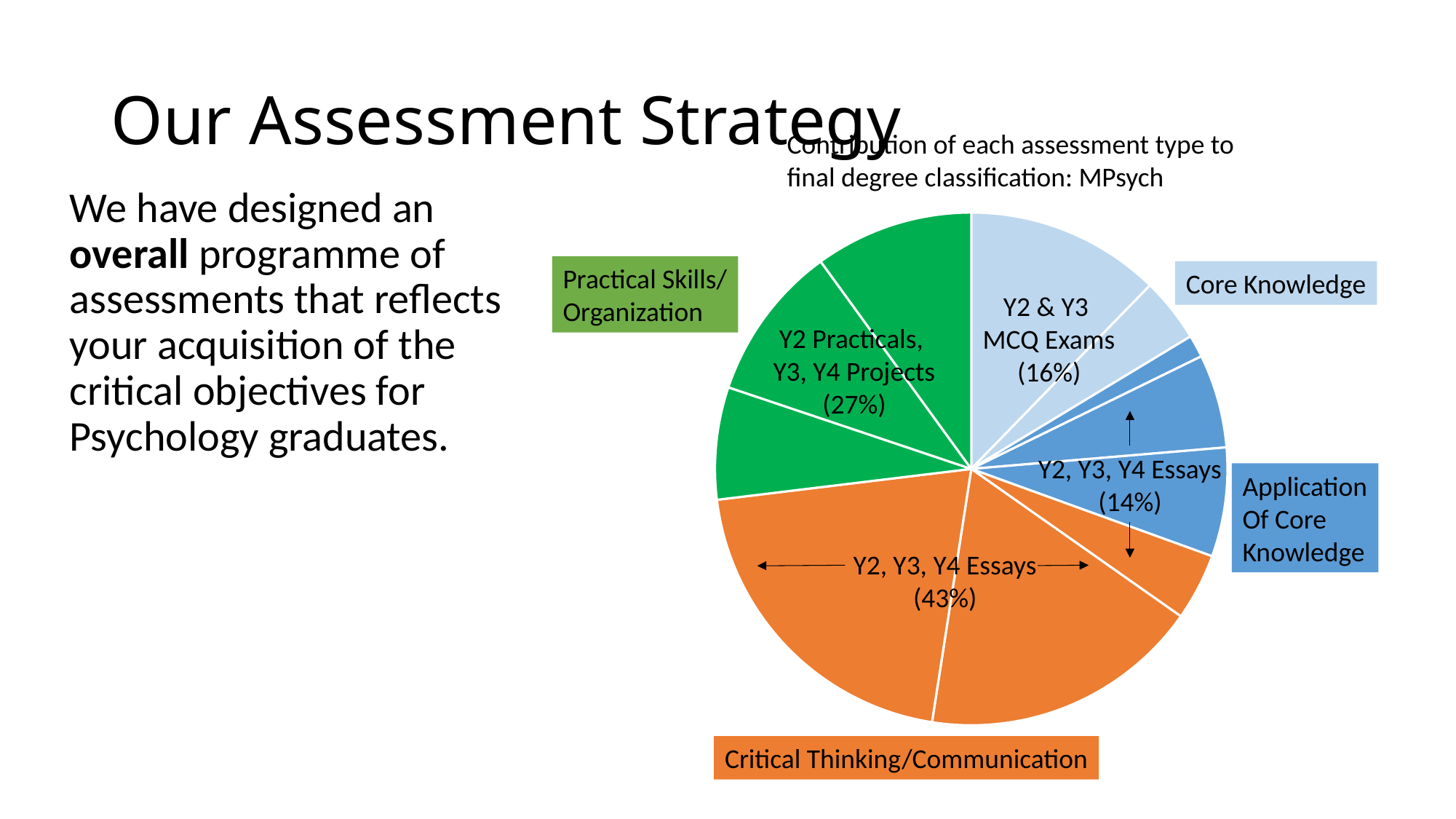
What percentage is attributed to Y2 Practicals, Y3, Y4 Projects (Practical Skills/Organization)? 27% Which assessment category contributes the smallest share to the final degree classification? Application Of Core Knowledge (Y2, Y3, Y4 Essays, 14%) Which assessment category contributes the largest share to the final degree classification? Critical Thinking/Communication (Y2, Y3, Y4 Essays, 43%) What is the difference in percentage points between the Critical Thinking/Communication share and the Practical Skills/Organization share? 16 How many labelled assessment categories are shown in the pie chart? 4 What percentage of the final degree classification comes from Y2 & Y3 MCQ Exams (Core Knowledge)? 16% What is the title of the pie chart? Contribution of each assessment type to final degree classification: MPsych What percentage is attributed to Y2, Y3, Y4 Essays under Application Of Core Knowledge? 14% What percentage is attributed to Y2, Y3, Y4 Essays under Critical Thinking/Communication? 43% What colour represents the Practical Skills/Organization category in the pie chart? Green What kind of chart is shown on the slide? Pie chart Which contributes more to the final degree classification: Core Knowledge MCQ Exams or Practical Skills/Organization? Practical Skills/Organization